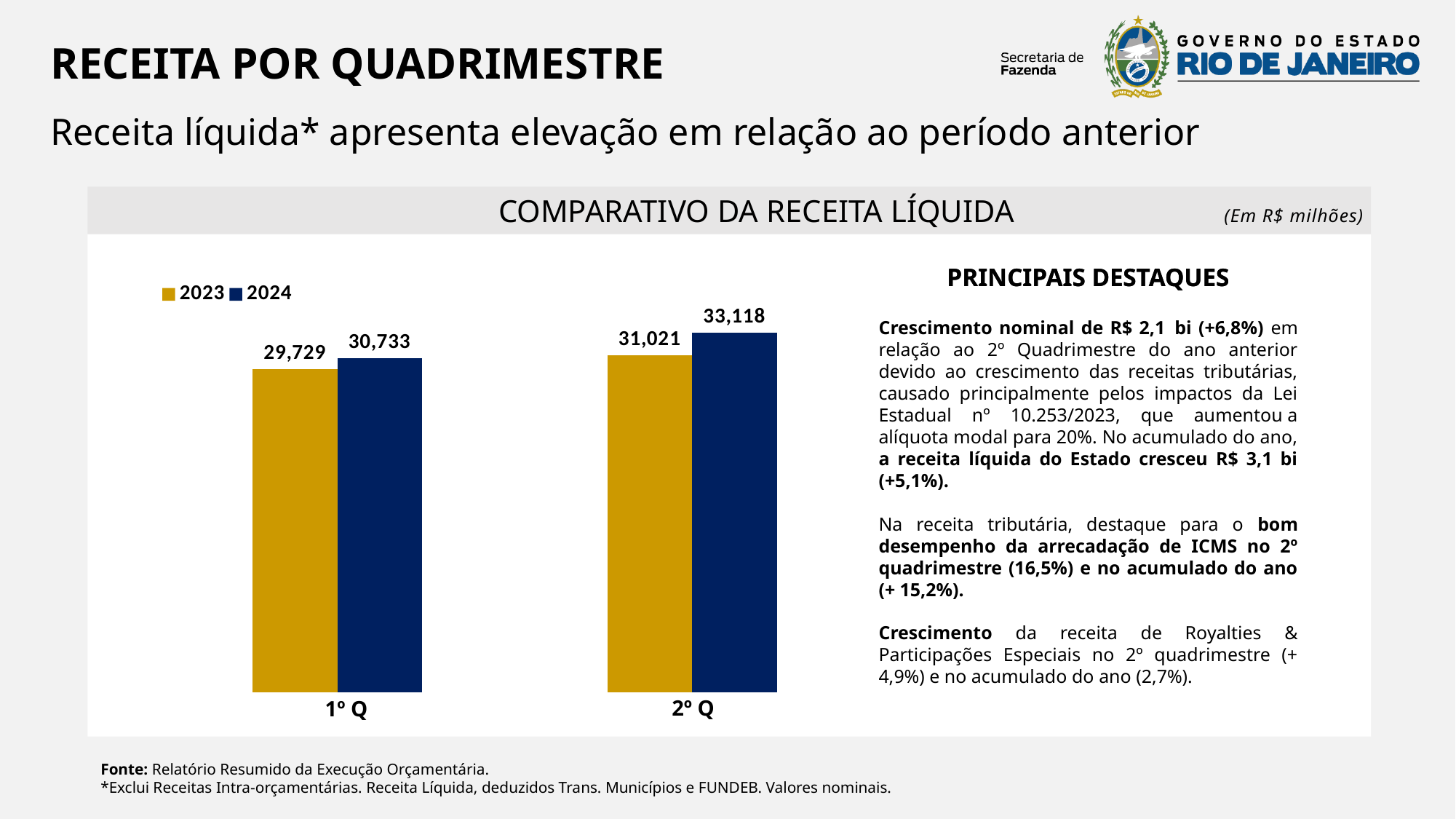
Which is larger: the 2023 value in 2º Q or the 2024 value in 1º Q? 2023 value in 2º Q What kind of chart is shown? Bar chart What is the value for 2024 in 1º Q? 30,733 What is the value for 2024 in 2º Q? 33,118 What is the value for 2023 in 2º Q? 31,021 How many categories are shown on the x axis? 2 Which bar has the highest value on the chart? 2024 in 2º Q What is the difference between the 2024 and 2023 values in 2º Q? 2,097 What is the value for 2023 in 1º Q? 29,729 What is the difference between the 2024 and 2023 values in 1º Q? 1,004 How many series does the legend list? 2 Which bar has the lowest value on the chart? 2023 in 1º Q